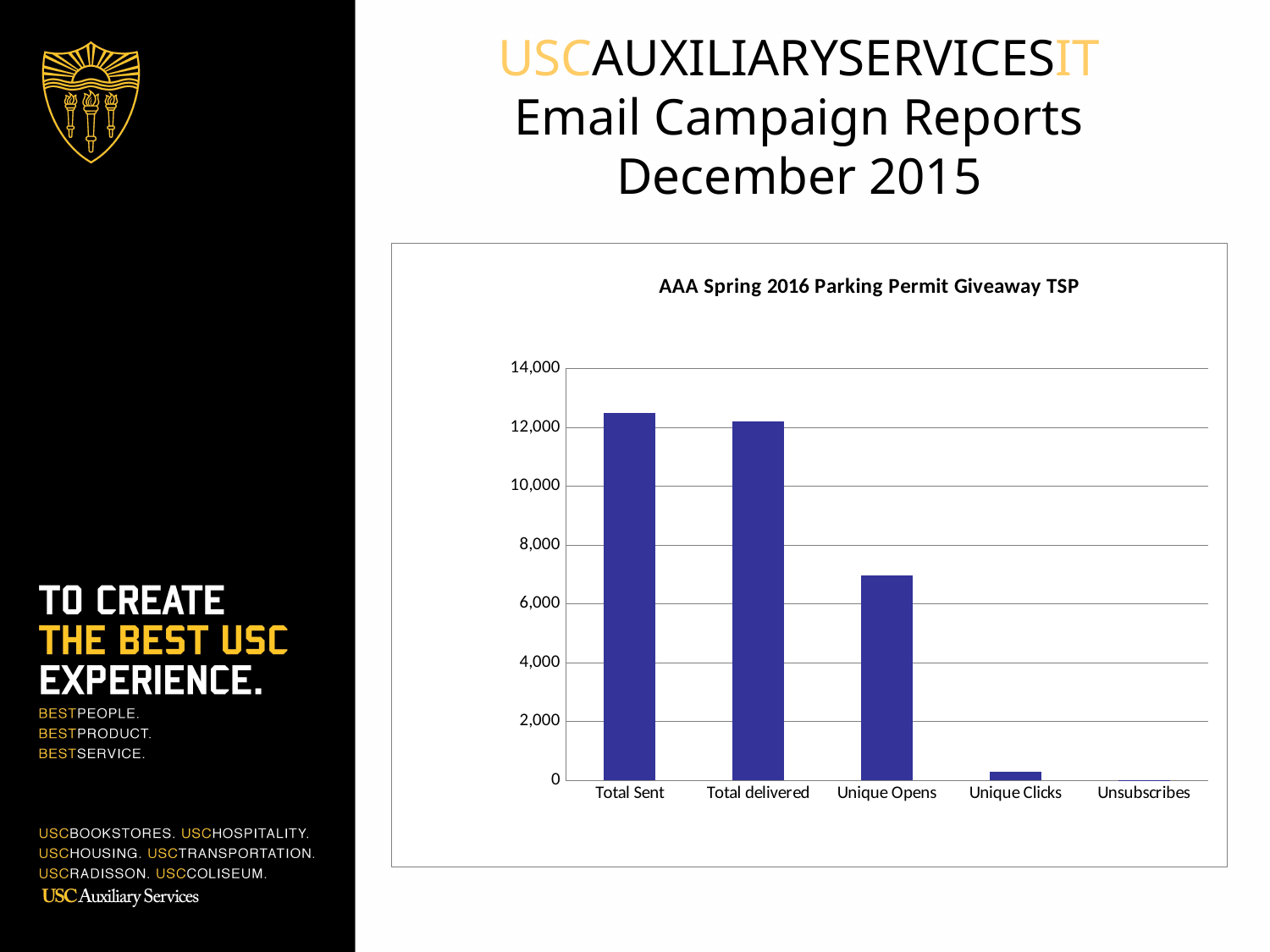
Is the value for Unique Opens greater or less than 8,000? less Which category has the lowest value in the chart? Unsubscribes Is the value for Total Sent greater or less than 12,000? greater What type of chart is shown on the slide? bar chart What is the title of the chart? AAA Spring 2016 Parking Permit Giveaway TSP Is the value for Unique Clicks greater or less than 2,000? less Which is larger, the value for Unique Clicks or the value for Unique Opens? Unique Opens How many categories are shown on the x axis of the chart? 5 Do the values rise or fall moving from left to right along the x axis? fall Which is larger, the value for Total delivered or the value for Unique Opens? Total delivered